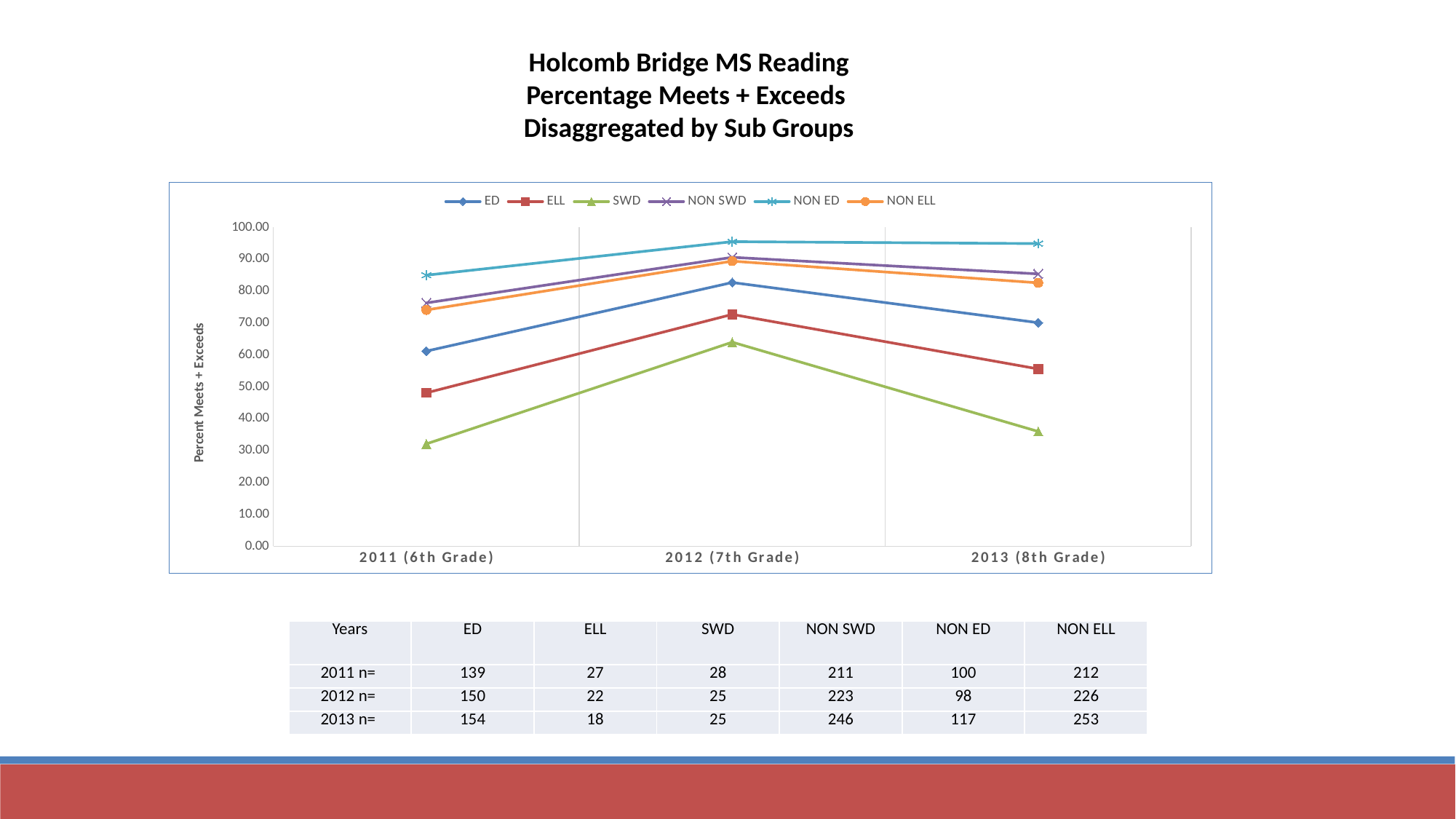
Is the value for ELL in 2011 (6th Grade) greater or less than 50.00? less What kind of chart is shown on the slide? line chart Does the SWD line rise or fall from 2012 (7th Grade) to 2013 (8th Grade)? fall Which sub group has the lowest value in 2011 (6th Grade)? SWD Is the value for NON ED in 2012 (7th Grade) greater or less than 90.00? greater Which sub group has the highest value in 2012 (7th Grade)? NON ED Is the value for SWD in 2011 (6th Grade) greater or less than 40.00? less What is the title of the vertical axis? Percent Meets + Exceeds How many points along the x axis does each series have? 3 Does the ED line rise or fall from 2011 (6th Grade) to 2012 (7th Grade)? rise How many series does the legend list? 6 Which is larger in 2013 (8th Grade), the value for ED or the value for ELL? ED